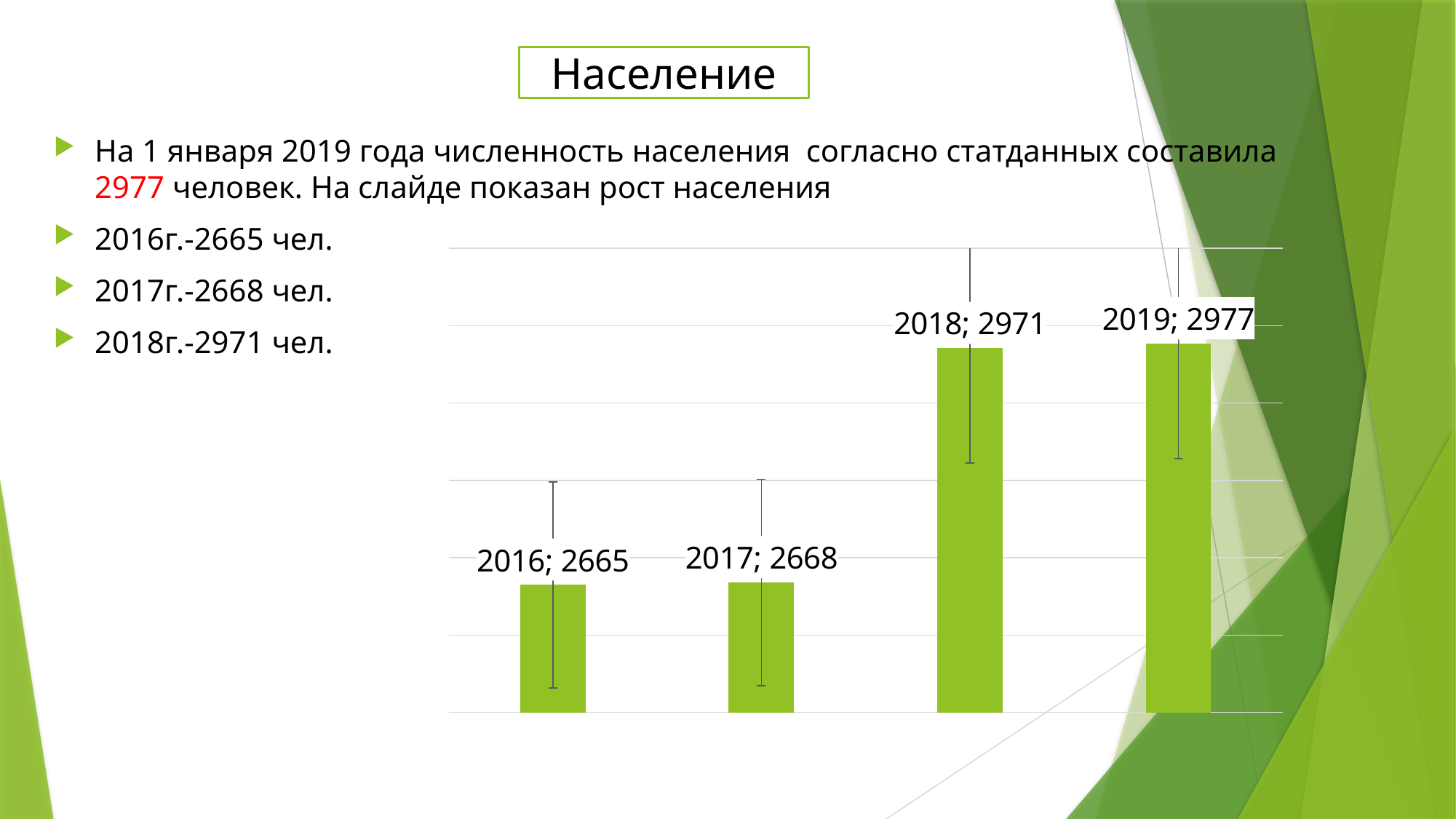
What is the population value shown for 2017 on the chart? 2668 What is the population value shown for 2018 on the chart? 2971 How many years (bars) are shown on the chart? 4 Which year has the lowest value on the chart? 2016 What is the difference between the values for 2018 and 2017? 303 What is the population value shown for 2016 on the chart? 2665 Do the values rise or fall from 2016 to 2019 on the chart? rise What is the difference between the values for 2019 and 2016? 312 Which year has the highest value on the chart? 2019 Which is larger, the value for 2018 or the value for 2016? 2018 What kind of chart is shown on the slide? bar chart What is the population value shown for 2019 on the chart? 2977